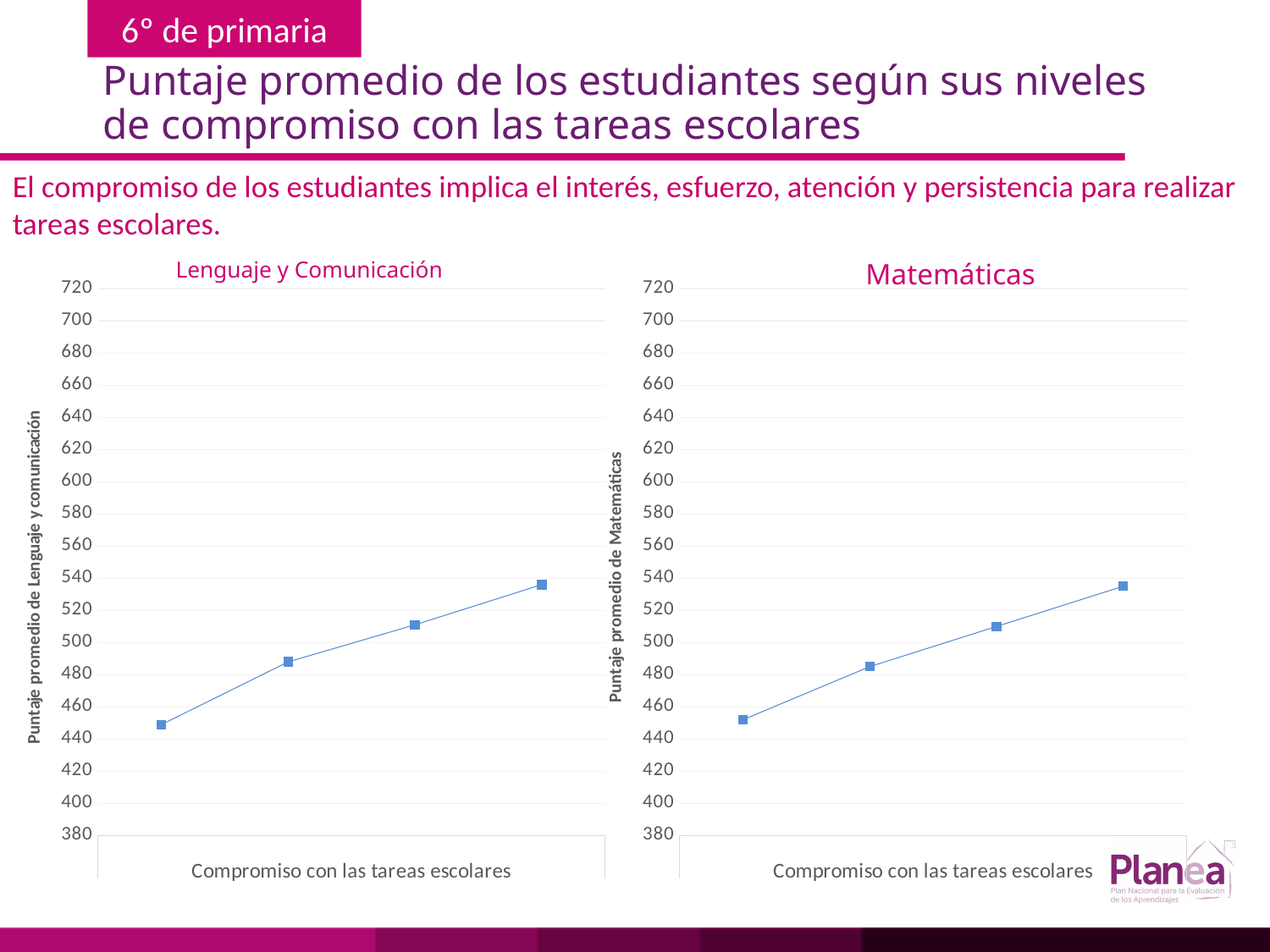
What kind of chart is the 'Matemáticas' chart? line chart In the 'Matemáticas' chart, how many data points are plotted? 4 In the 'Lenguaje y Comunicación' chart, do the values rise or fall from left to right along the x axis? rise In the 'Lenguaje y Comunicación' chart, is the value of the rightmost point greater or less than 520? greater In the 'Lenguaje y Comunicación' chart, is the value of the leftmost point greater or less than 460? less In the 'Matemáticas' chart, do the values rise or fall from left to right along the x axis? rise In the 'Matemáticas' chart, is the value of the leftmost point greater or less than 460? less What kind of chart is the 'Lenguaje y Comunicación' chart? line chart In the 'Lenguaje y Comunicación' chart, how many data points are plotted? 4 What is the x-axis title of the 'Matemáticas' chart? Compromiso con las tareas escolares What is the y-axis title of the 'Lenguaje y Comunicación' chart? Puntaje promedio de Lenguaje y comunicación